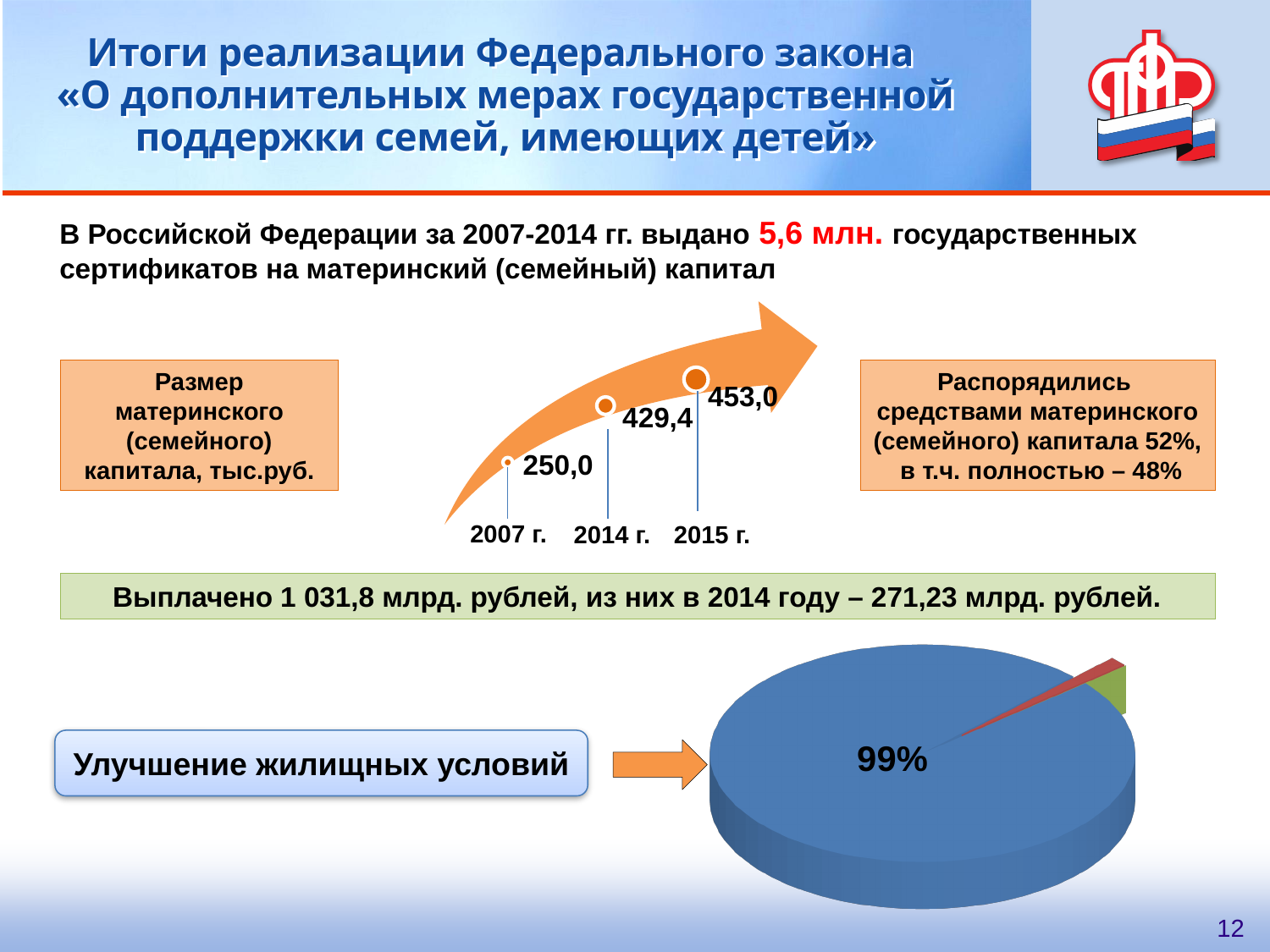
On the chart of the size of maternity (family) capital, what is the value for 2014 г.? 429,4 On the pie chart at the bottom of the slide, what share does the largest (blue) slice have? 99% On the chart of the size of maternity (family) capital, how many data points are plotted? 3 What kind of chart is shown at the bottom of the slide next to 'Улучшение жилищных условий'? pie chart On the chart of the size of maternity (family) capital, which year has the lowest value? 2007 г. On the chart of the size of maternity (family) capital, what is the value for 2007 г.? 250,0 On the chart of the size of maternity (family) capital, which is larger: the value for 2014 г. or for 2007 г.? 2014 г. On the chart of the size of maternity (family) capital, what is the value for 2015 г.? 453,0 On the chart of the size of maternity (family) capital, do the values rise or fall from 2007 г. to 2015 г.? rise On the chart of the size of maternity (family) capital, which year has the highest value? 2015 г. On the chart of the size of maternity (family) capital, what is the difference between the values for 2015 г. and 2014 г.? 23,6 On the chart of the size of maternity (family) capital, what is the difference between the values for 2014 г. and 2007 г.? 179,4